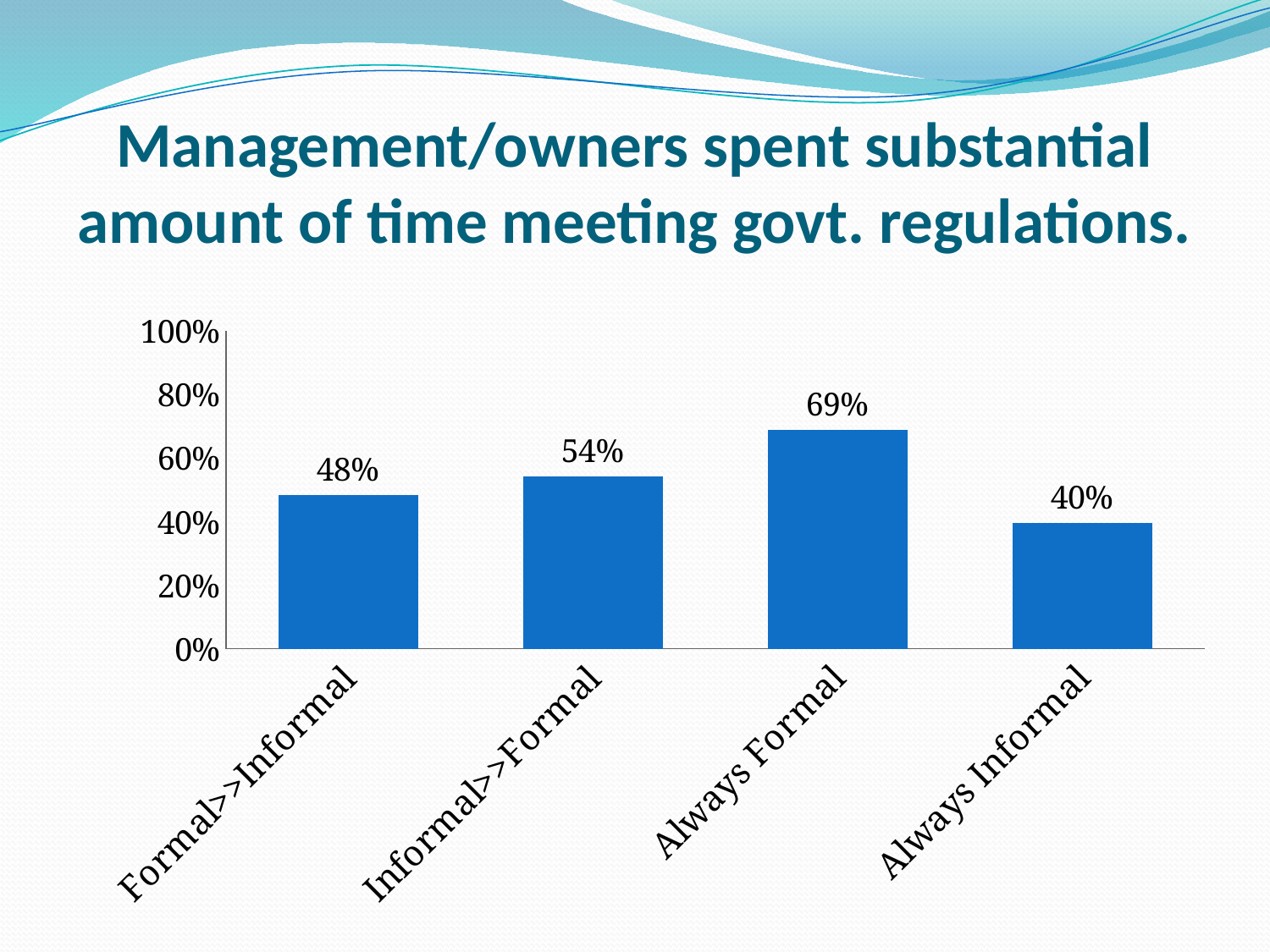
What is the difference between the values for Informal>>Formal and Formal>>Informal? 6% What is the value for Formal>>Informal? 48% What is the value for Always Informal? 40% How many categories are shown on the x axis? 4 What is the title of the slide? Management/owners spent substantial amount of time meeting govt. regulations. What kind of chart is shown on the slide? bar chart What is the difference between the values for Always Formal and Always Informal? 29% Which category has the highest value? Always Formal What is the value for Always Formal? 69% Which category has the lowest value? Always Informal Is the value for Always Formal greater or less than 60%? greater Which is larger, the value for Informal>>Formal or the value for Formal>>Informal? Informal>>Formal